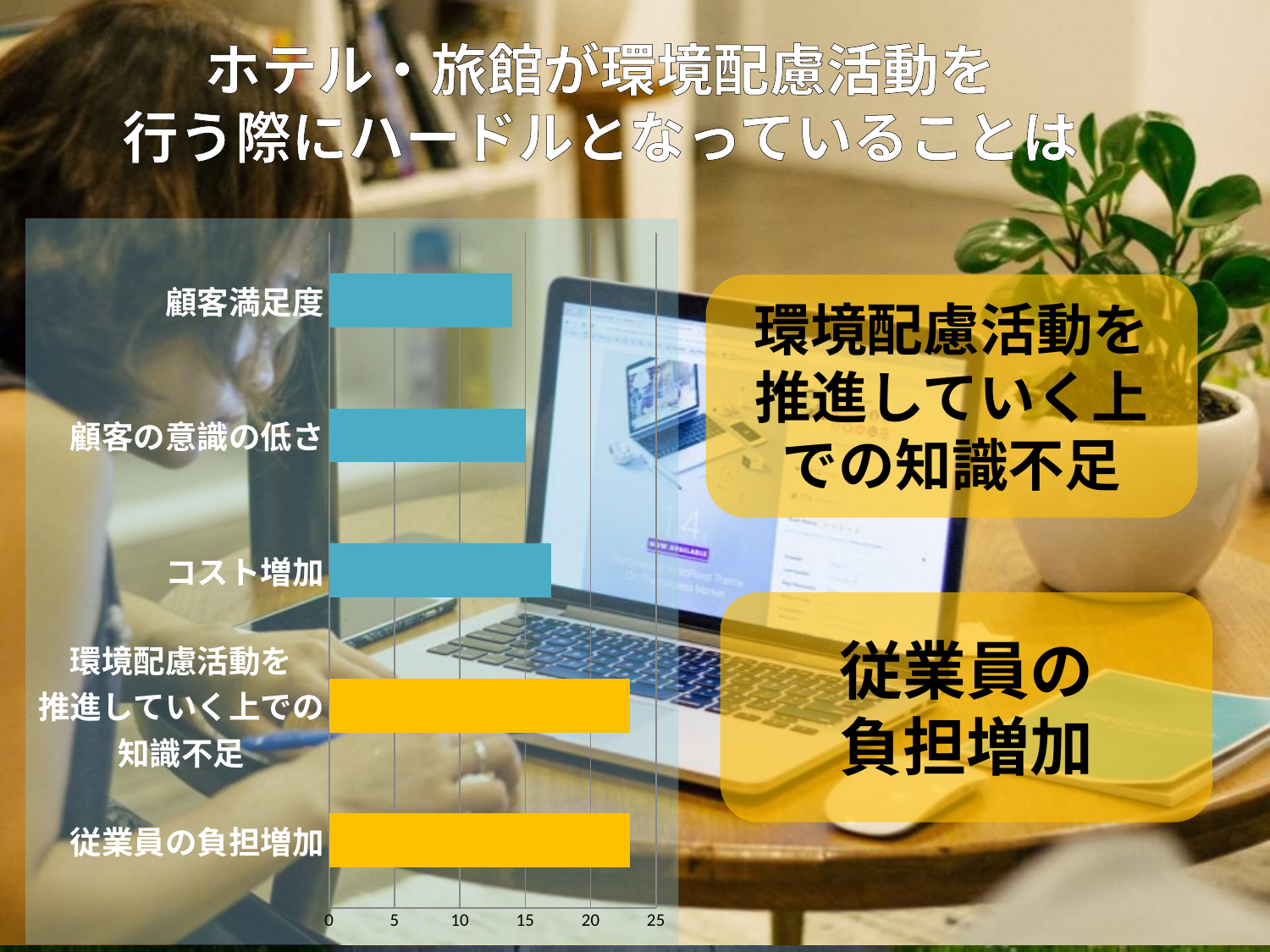
Is the value for コスト増加 greater or less than 15? greater What kind of chart is shown on the slide? bar chart Is the value for 環境配慮活動を推進していく上での知識不足 greater or less than 20? greater Is the value for 従業員の負担増加 greater or less than 20? greater How many categories does the bar chart show? 5 Which is larger, the value for コスト増加 or the value for 顧客満足度? コスト増加 Which is larger, the value for 従業員の負担増加 or the value for コスト増加? 従業員の負担増加 Which is larger, the value for 環境配慮活動を推進していく上での知識不足 or the value for 顧客の意識の低さ? 環境配慮活動を推進していく上での知識不足 What is the highest value shown on the chart's axis? 25 Which two categories have bars coloured yellow instead of blue? 環境配慮活動を推進していく上での知識不足 and 従業員の負担増加